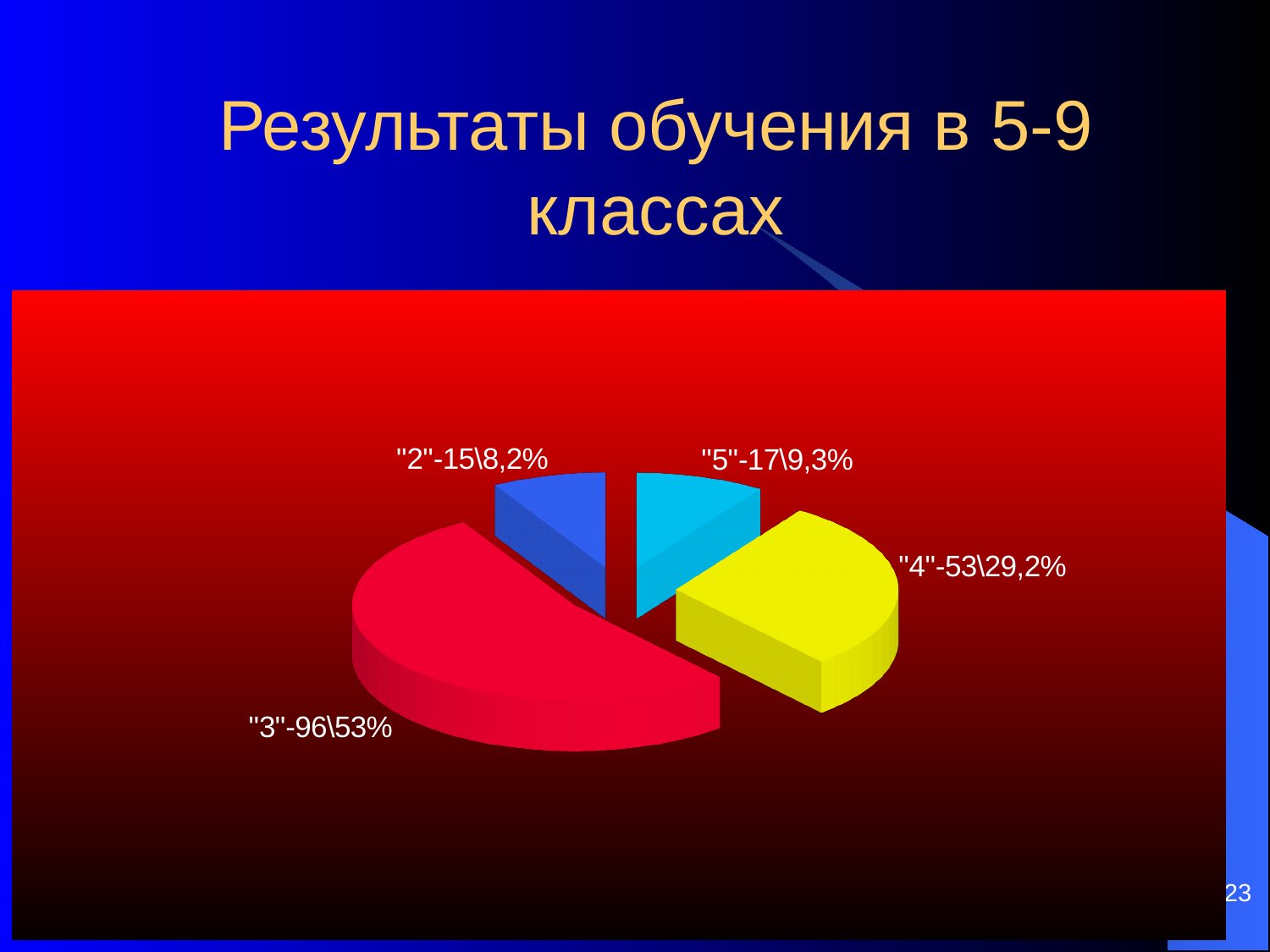
What colour is the "4" slice of the pie chart? yellow What percentage is shown for the "2" slice of the pie chart? 8,2% What count is shown for the "3" slice of the pie chart? 96 What is the difference between the counts for the "3" and "4" slices? 43 How many slices does the pie chart have? 4 Which slice of the pie chart is the smallest? "2" Which slice of the pie chart is the largest? "3" What percentage is shown for the "4" slice of the pie chart? 29,2% What is the title of the slide with the pie chart? Результаты обучения в 5-9 классах Which has a larger count, the "5" slice or the "2" slice? "5" What count is shown for the "5" slice of the pie chart? 17 What kind of chart is shown on the slide? pie chart